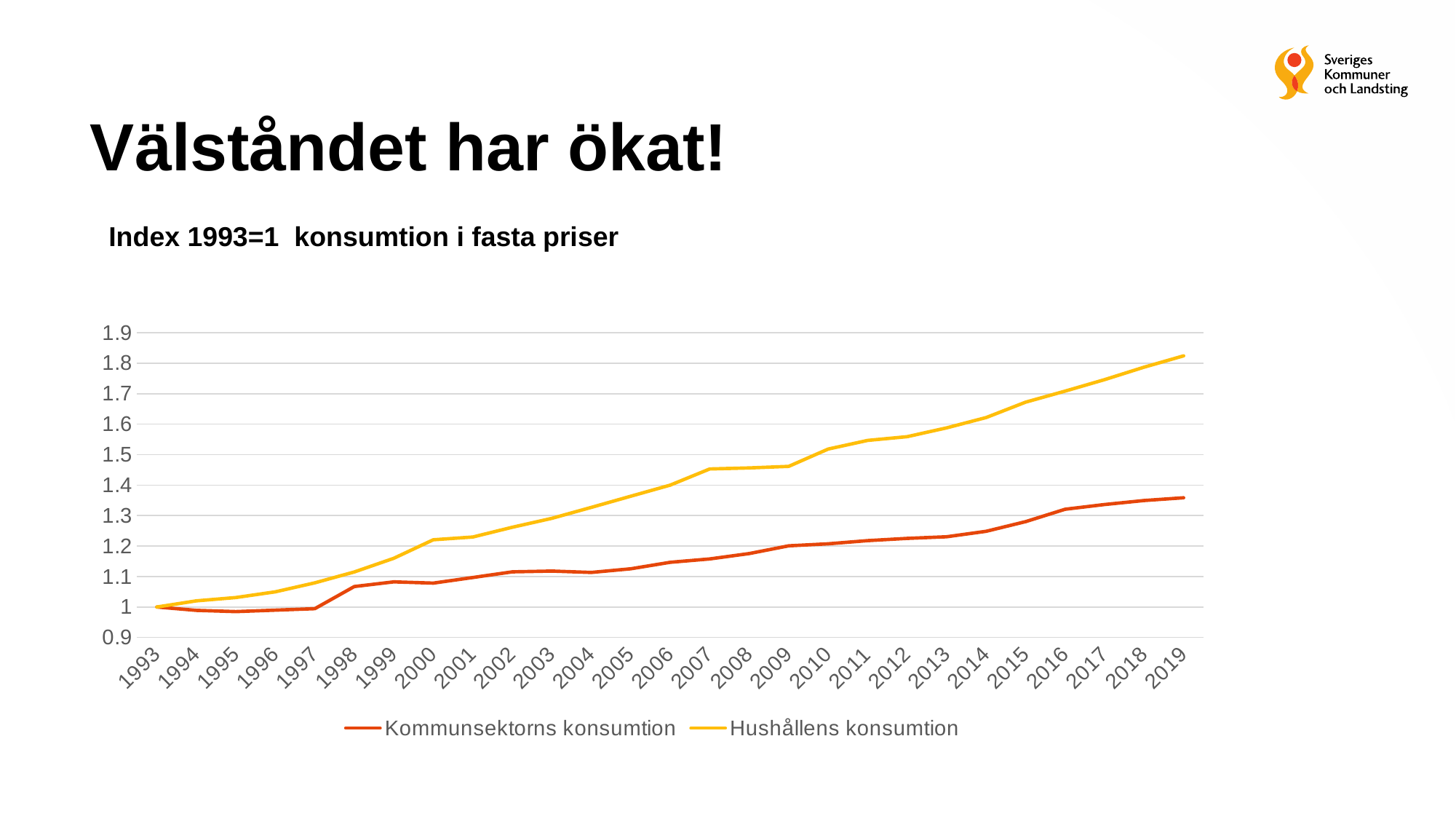
In 2019, which series has the higher value, Kommunsektorns konsumtion or Hushållens konsumtion? Hushållens konsumtion What is the index value for Hushållens konsumtion in 1993? 1 What kind of chart is shown on the slide? line chart Which colour is used for the Hushållens konsumtion line? yellow What is the index value for Kommunsektorns konsumtion in 1993? 1 Does Hushållens konsumtion rise or fall from 1993 to 2019? rise In which year is Hushållens konsumtion at its lowest value? 1993 Is the value for Kommunsektorns konsumtion in 2019 greater or less than 1.4? less In which year does Hushållens konsumtion reach its highest value? 2019 Is the value for Hushållens konsumtion in 2019 greater or less than 1.7? greater How many years are shown along the x axis? 27 How many series does the legend list? 2